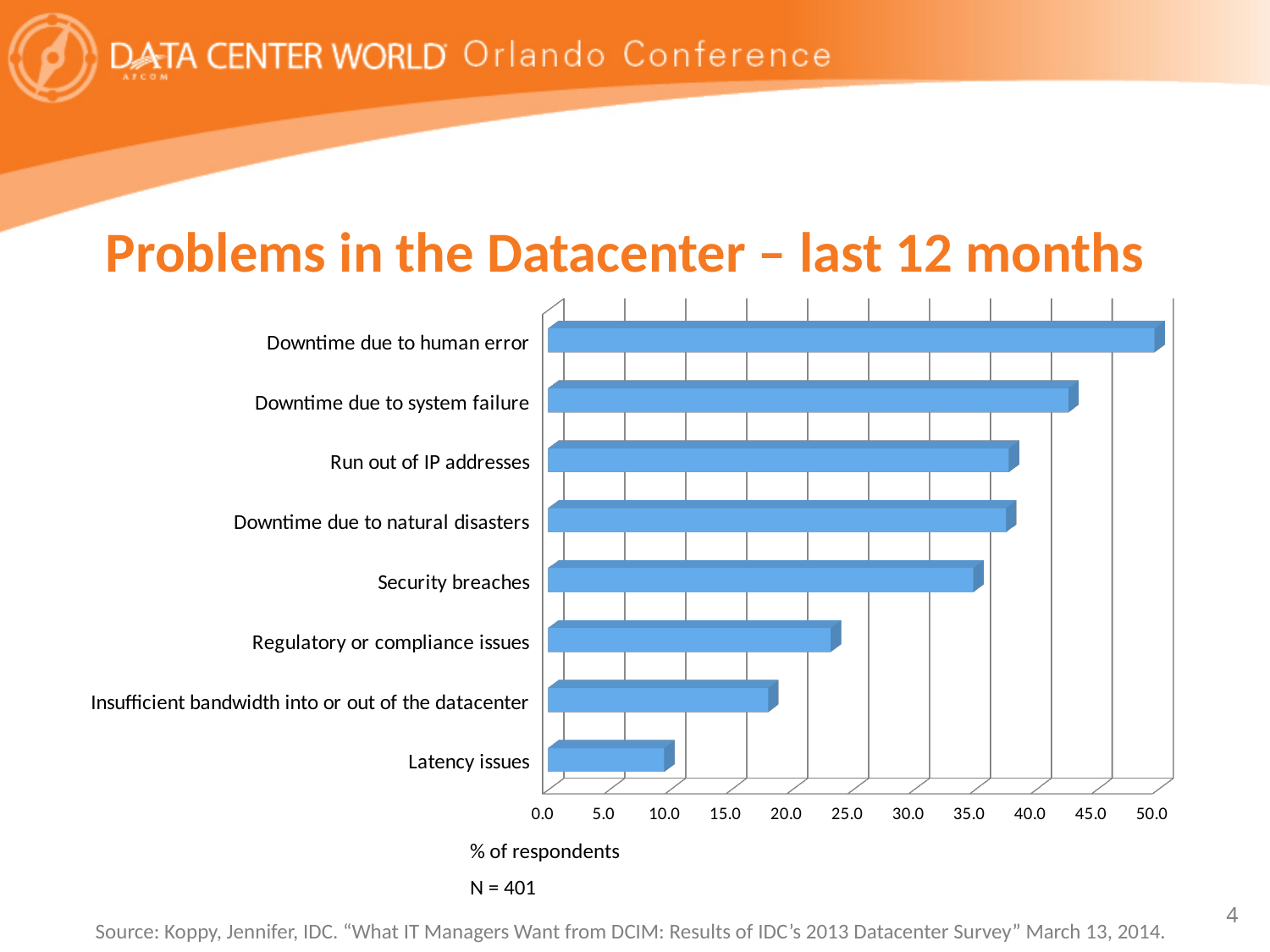
How many categories (problems) are plotted in the chart? 8 Is the value for Insufficient bandwidth into or out of the datacenter greater or less than 20.0? less What kind of chart is shown on the slide? bar chart Which problem has the lowest percentage of respondents? Latency issues Is the value for Security breaches greater or less than 40.0? less Is the value for Regulatory or compliance issues greater or less than 20.0? greater Which problem has the highest percentage of respondents? Downtime due to human error Which is larger: the value for Security breaches or the value for Regulatory or compliance issues? Security breaches What is the label on the horizontal axis of the chart? % of respondents